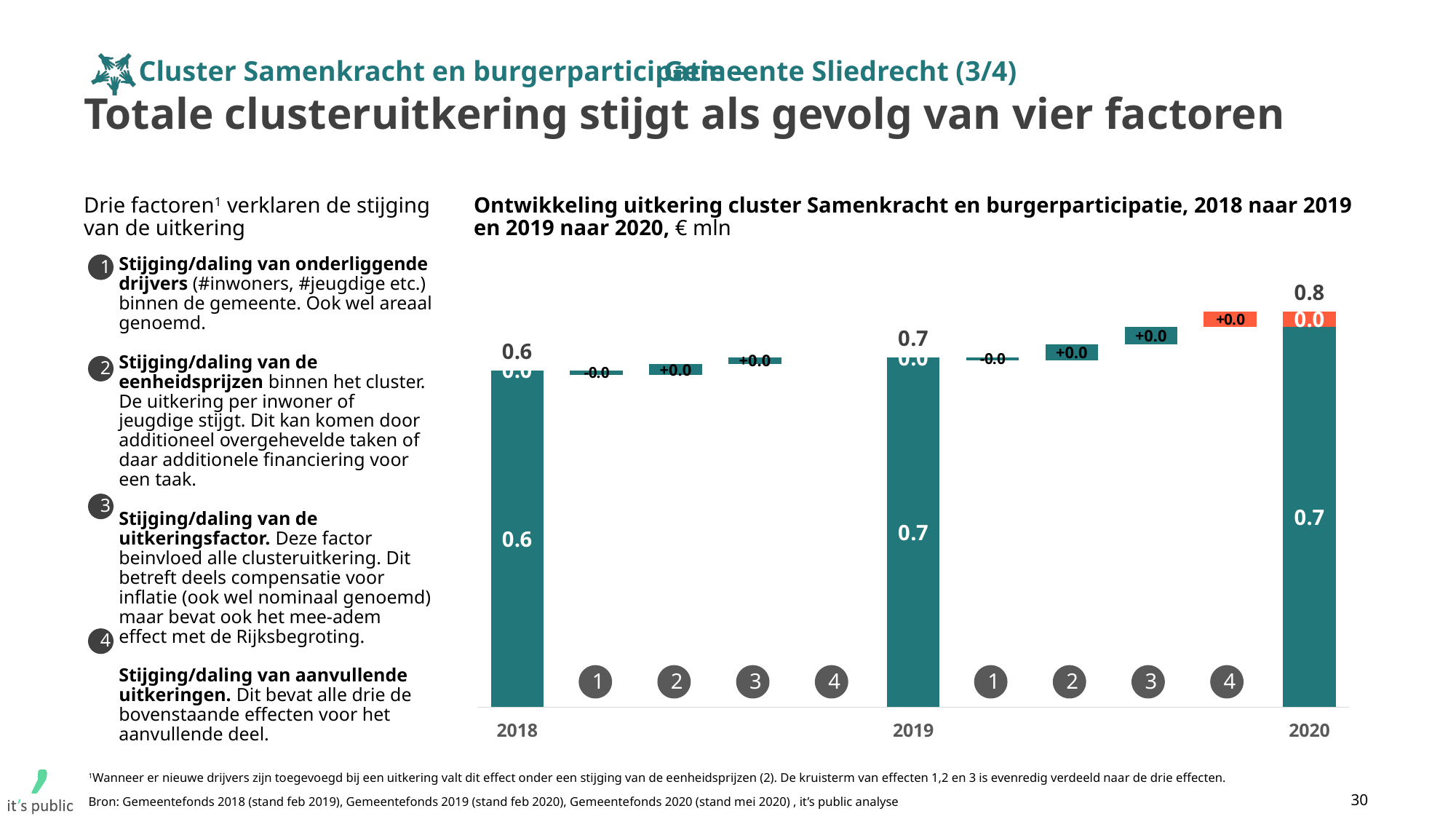
What is the total uitkering shown for 2018? 0.6 What is the total uitkering shown for 2019? 0.7 What is the difference between the 2020 total and the 2018 total? 0.2 Do the yearly totals rise or fall from 2018 to 2020? rise What is the difference between the 2019 total and the 2018 total? 0.1 What is the total uitkering shown for 2020? 0.8 What kind of chart is used to show the development of the uitkering? bar chart (waterfall) Which year has the lowest total uitkering? 2018 In what unit are the values in the chart expressed? € mln How many year totals are shown in the chart? 3 Which year has the highest total uitkering? 2020 Which is larger, the total for 2019 or the total for 2018? 2019